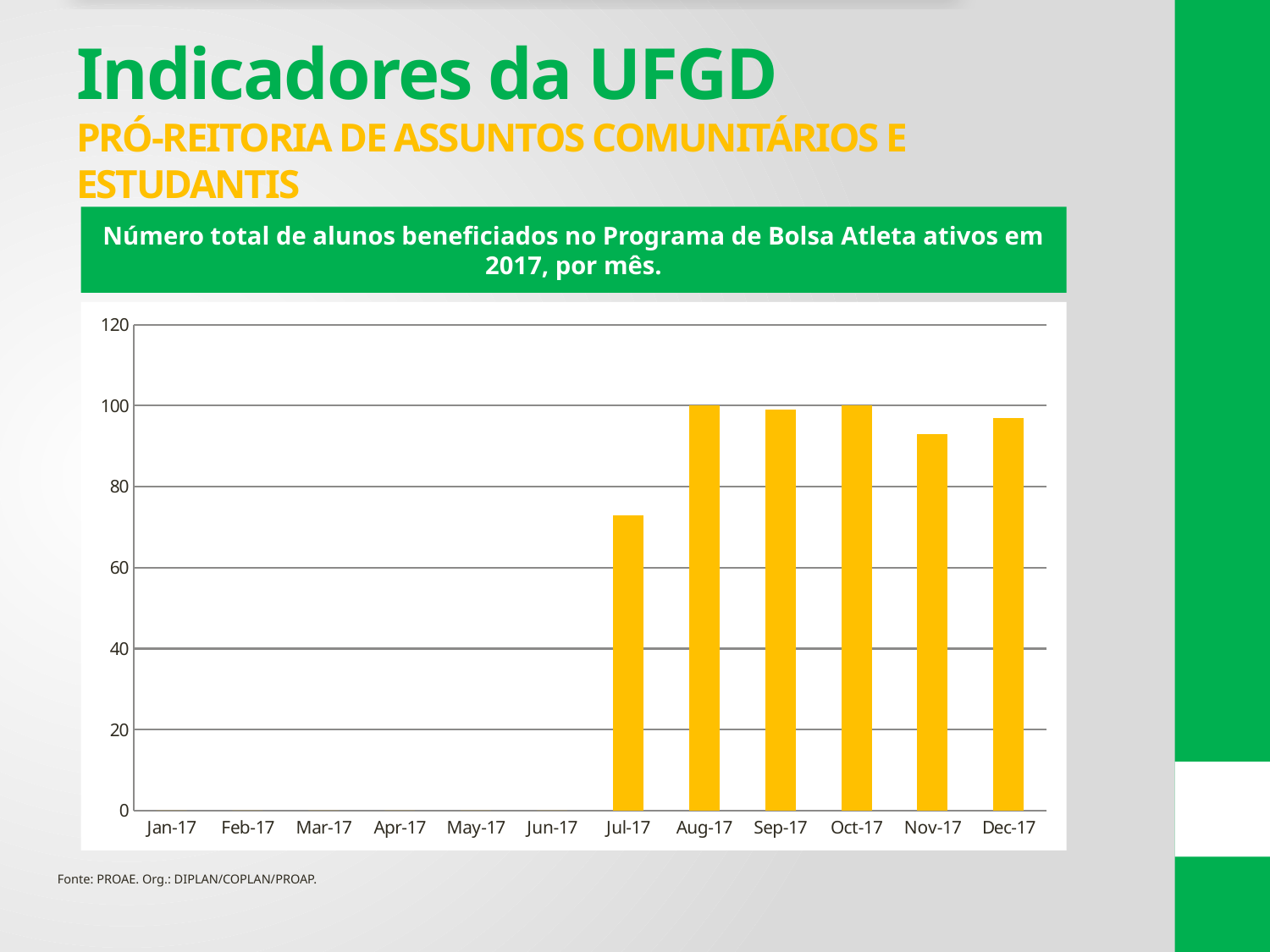
What colour are the bars in the chart? yellow Which is larger, the value for Jul-17 or the value for Nov-17? Nov-17 How many months are listed along the x axis of the chart? 12 Is the value for Nov-17 greater or less than 100? less Is the value for Dec-17 greater or less than 80? greater What is the title of the chart? Número total de alunos beneficiados no Programa de Bolsa Atleta ativos em 2017, por mês. Does the value rise or fall from Jul-17 to Aug-17? rise Is the value for Jul-17 greater or less than 80? less How many months in the chart have a visible bar? 6 What kind of chart is shown on the slide? bar chart Which month has the lowest bar among the months with a visible bar? Jul-17